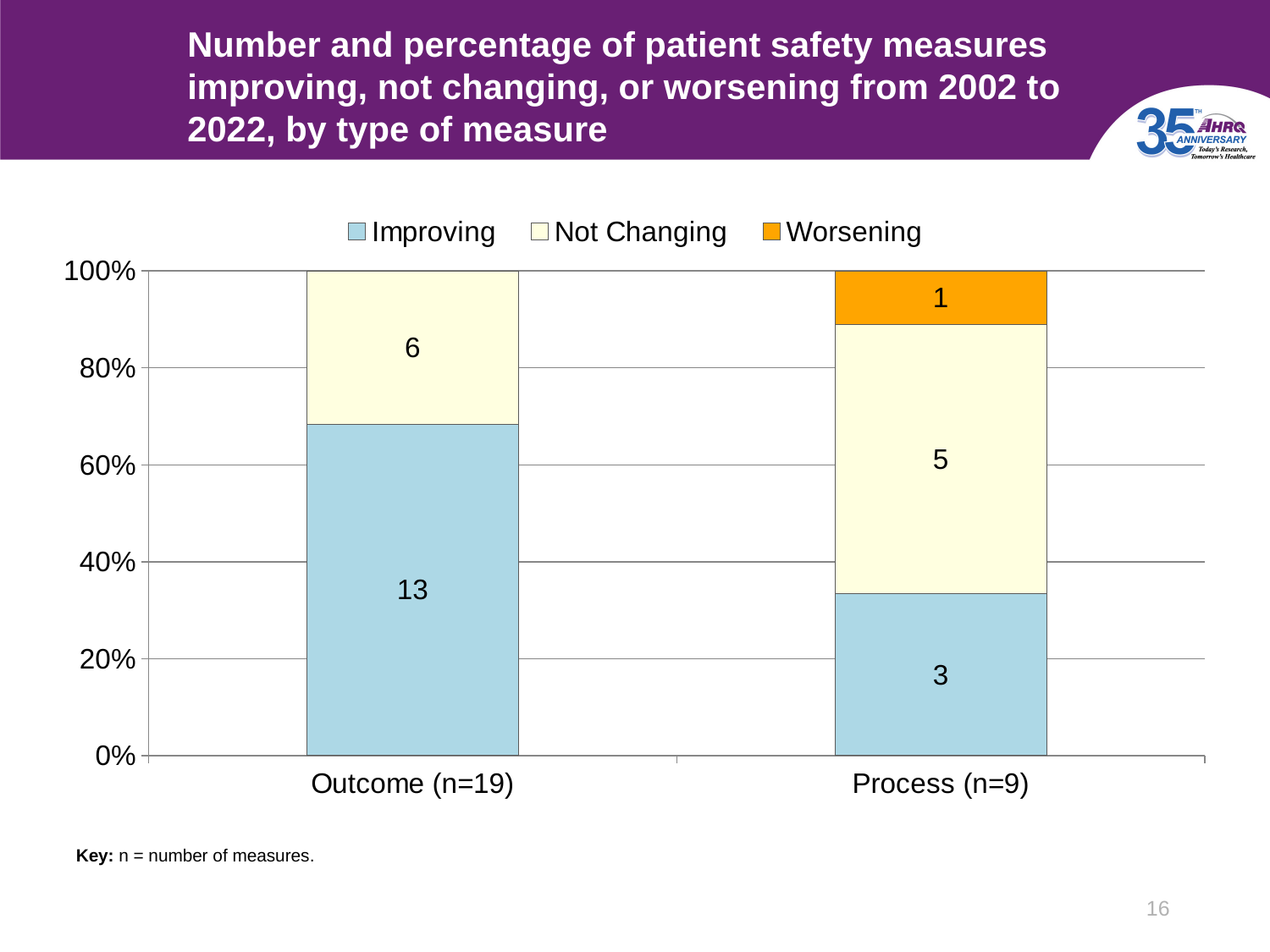
What is the total number of measures in the Outcome bar? 19 What is the difference between the number of improving outcome measures and improving process measures? 10 How many process measures are worsening? 1 How many series does the legend list? 3 What is the total number of measures in the Process bar? 9 Which has more improving measures, Outcome or Process? Outcome Is the share of improving measures for Outcome greater or less than 60%? greater What kind of chart is shown on the slide? Stacked bar chart How many patient safety outcome measures are improving? 13 How many outcome measures are not changing? 6 How many process measures are not changing? 5 Is the share of improving measures for Process greater or less than 40%? less